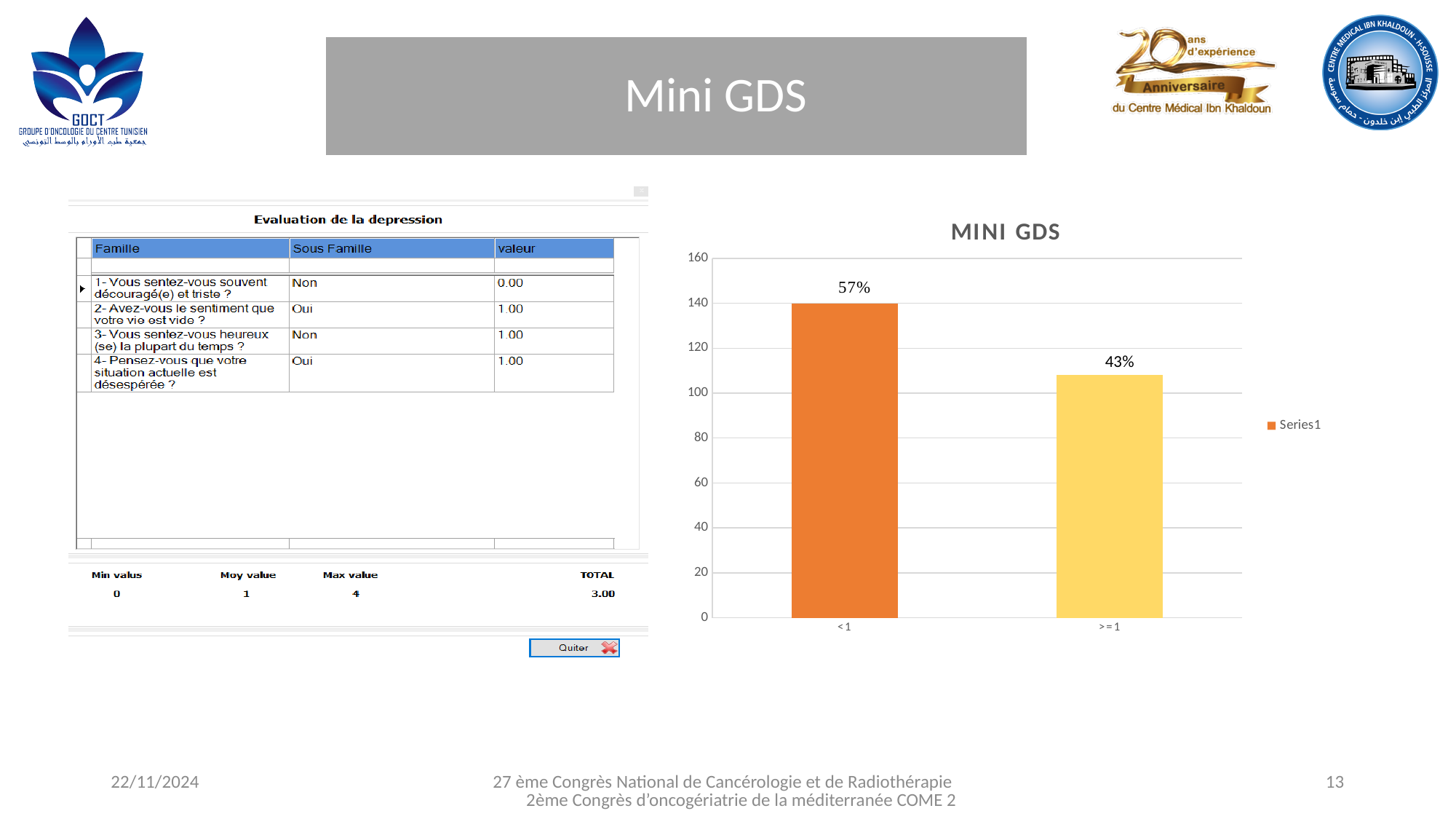
In the MINI GDS chart, is the bar for ">= 1" greater or less than 120 on the vertical axis? less How many series does the legend of the MINI GDS chart list? 1 What data label is shown on the bar for the ">= 1" category in the MINI GDS chart? 43% What type of chart is the MINI GDS chart? Bar chart What is the difference between the percentage labels of the "< 1" and ">= 1" bars in the MINI GDS chart? 14% Which category has the shortest bar in the MINI GDS chart? >= 1 In the MINI GDS chart, is the bar for ">= 1" greater or less than 100 on the vertical axis? greater What data label is shown on the bar for the "< 1" category in the MINI GDS chart? 57% How many categories are plotted in the MINI GDS chart? 2 In the MINI GDS chart, which bar is taller: "< 1" or ">= 1"? < 1 In the MINI GDS chart, is the bar for "< 1" greater or less than 120 on the vertical axis? greater Which category has the tallest bar in the MINI GDS chart? < 1